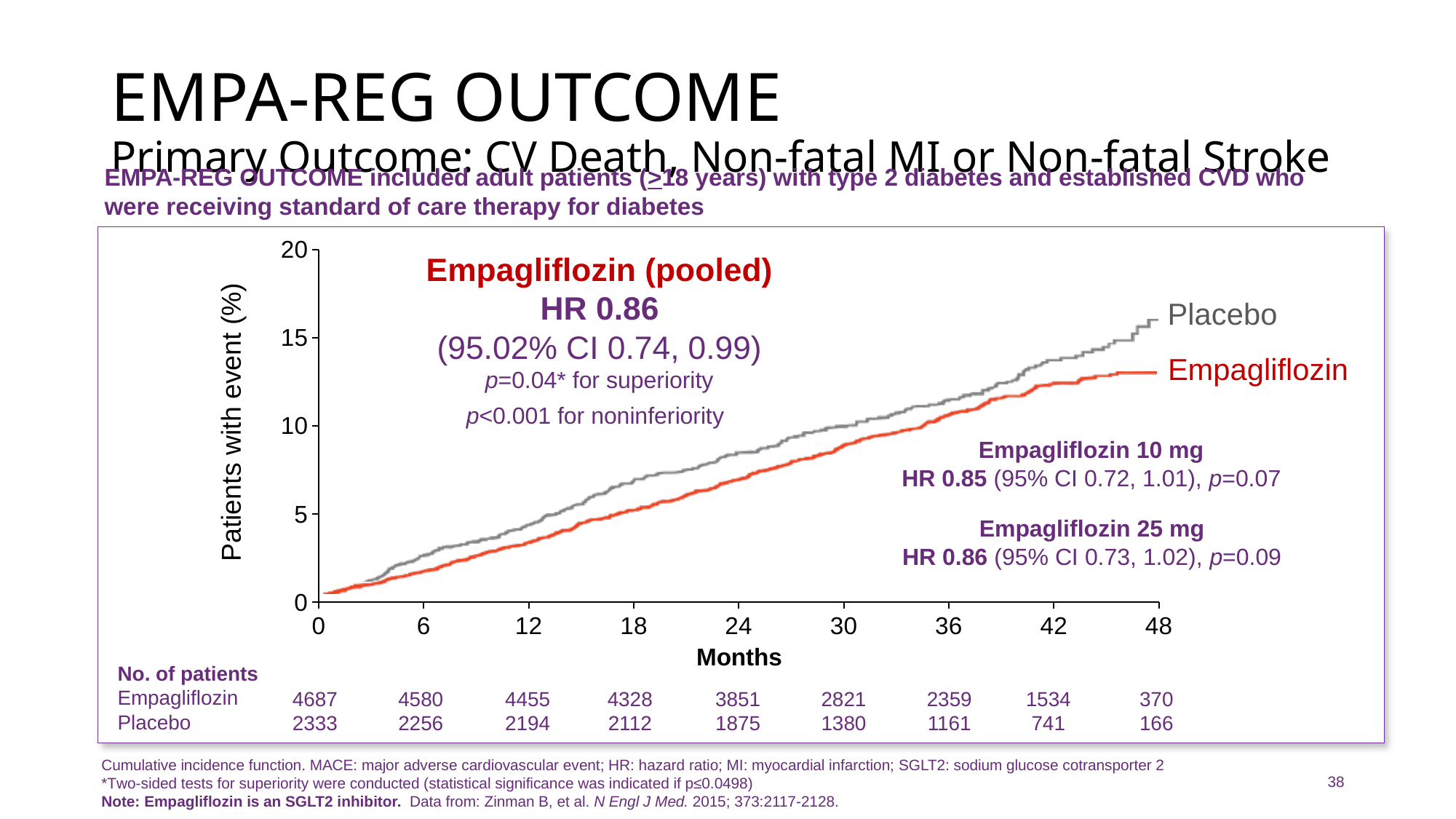
How many Placebo patients were at risk at month 48? 166 What kind of chart is shown on the slide? Line chart At 48 months, which curve is higher: Placebo or Empagliflozin? Placebo What is the label of the y-axis? Patients with event (%) What is the difference between the number of Empagliflozin and Placebo patients at month 0? 2354 What is the pooled hazard ratio for Empagliflozin shown on the chart? HR 0.86 Do the cumulative event curves rise or fall as months increase? Rise How many Empagliflozin patients were at risk at month 0? 4687 Is the Empagliflozin curve at 24 months greater or less than 10%? less Is the Placebo curve at 48 months greater or less than 15%? greater How many series (treatment groups) are plotted on the chart? 2 Is the Empagliflozin curve at 48 months greater or less than 15%? less